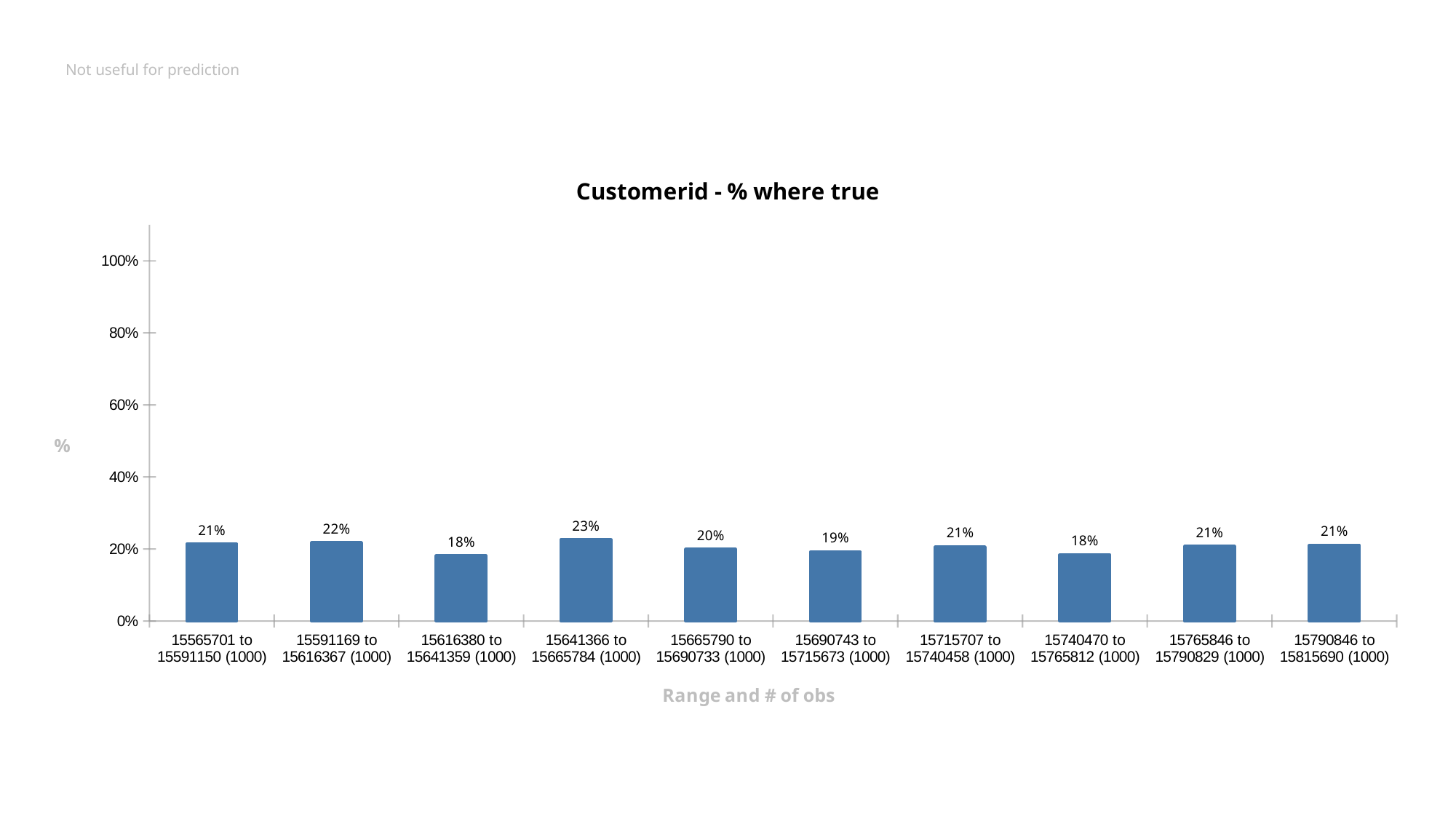
What is the value for the range 15690743 to 15715673 (1000)? 19% Which is larger, the value for 15591169 to 15616367 (1000) or the value for 15690743 to 15715673 (1000)? 15591169 to 15616367 (1000) What is the difference between the values for 15641366 to 15665784 (1000) and 15616380 to 15641359 (1000)? 5% How many ranges are shown on the x axis? 10 What kind of chart is shown? bar chart What is the label of the x axis? Range and # of obs What is the value for the range 15565701 to 15591150 (1000)? 21% What is the value for the range 15641366 to 15665784 (1000)? 23% Which range has the highest value? 15641366 to 15665784 (1000) Is the value for 15641366 to 15665784 (1000) greater or less than 40%? less What is the value for the range 15665790 to 15690733 (1000)? 20% What is the title of the chart? Customerid - % where true